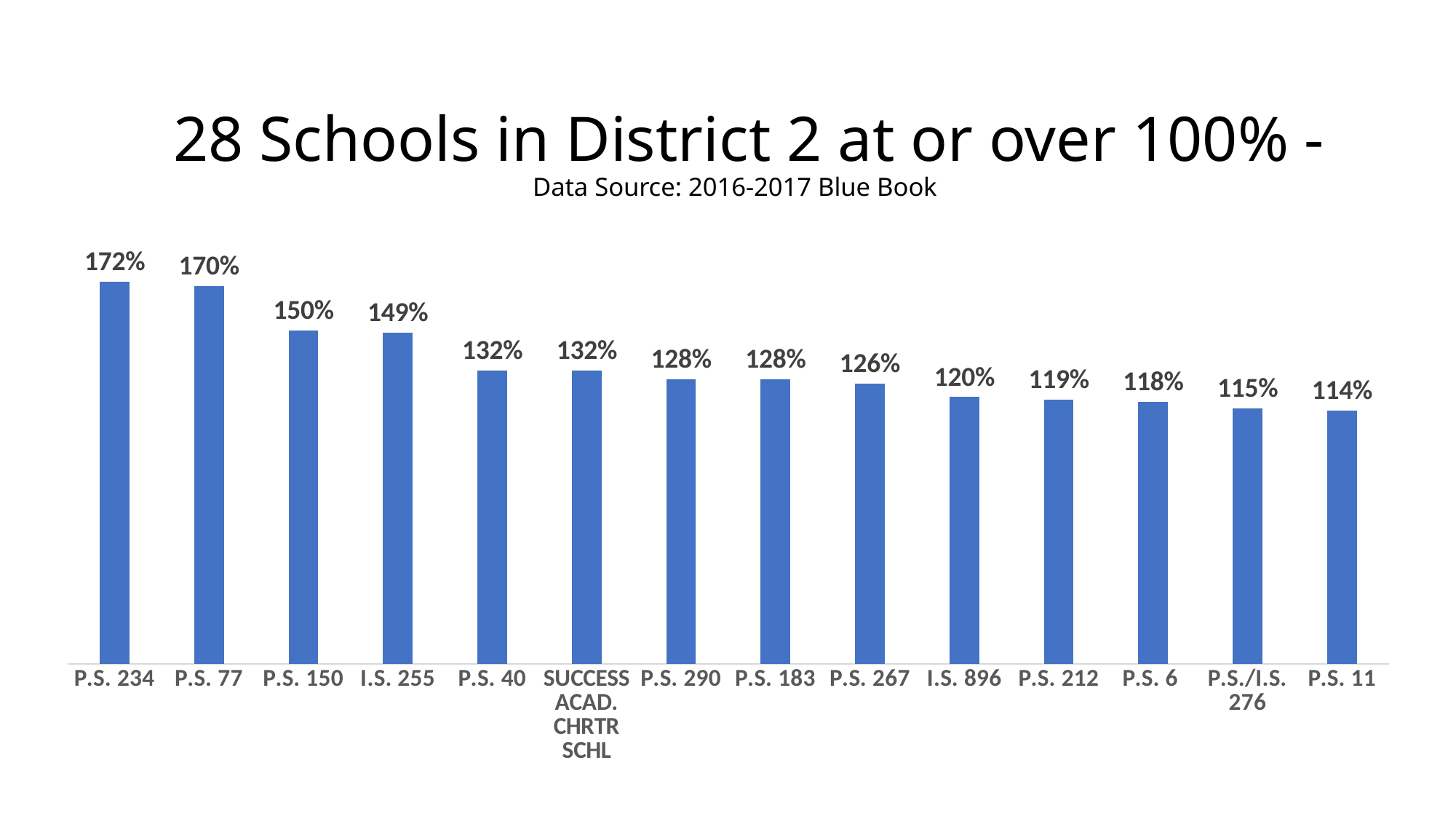
What is the value for I.S. 255? 149% What is the value for P.S. 11? 114% What is the value for P.S. 234? 172% Which school has the highest value? P.S. 234 Do the values rise or fall from left to right along the x axis? Fall Which school has the lowest value? P.S. 11 What is the value for SUCCESS ACAD. CHRTR SCHL? 132% Which is larger, the value for P.S. 77 or the value for P.S. 150? P.S. 77 What kind of chart is shown on the slide? Bar chart What is the difference between the values for P.S. 234 and P.S. 11? 58% What is the difference between the values for P.S. 150 and P.S. 40? 18% How many schools are shown on the chart? 14